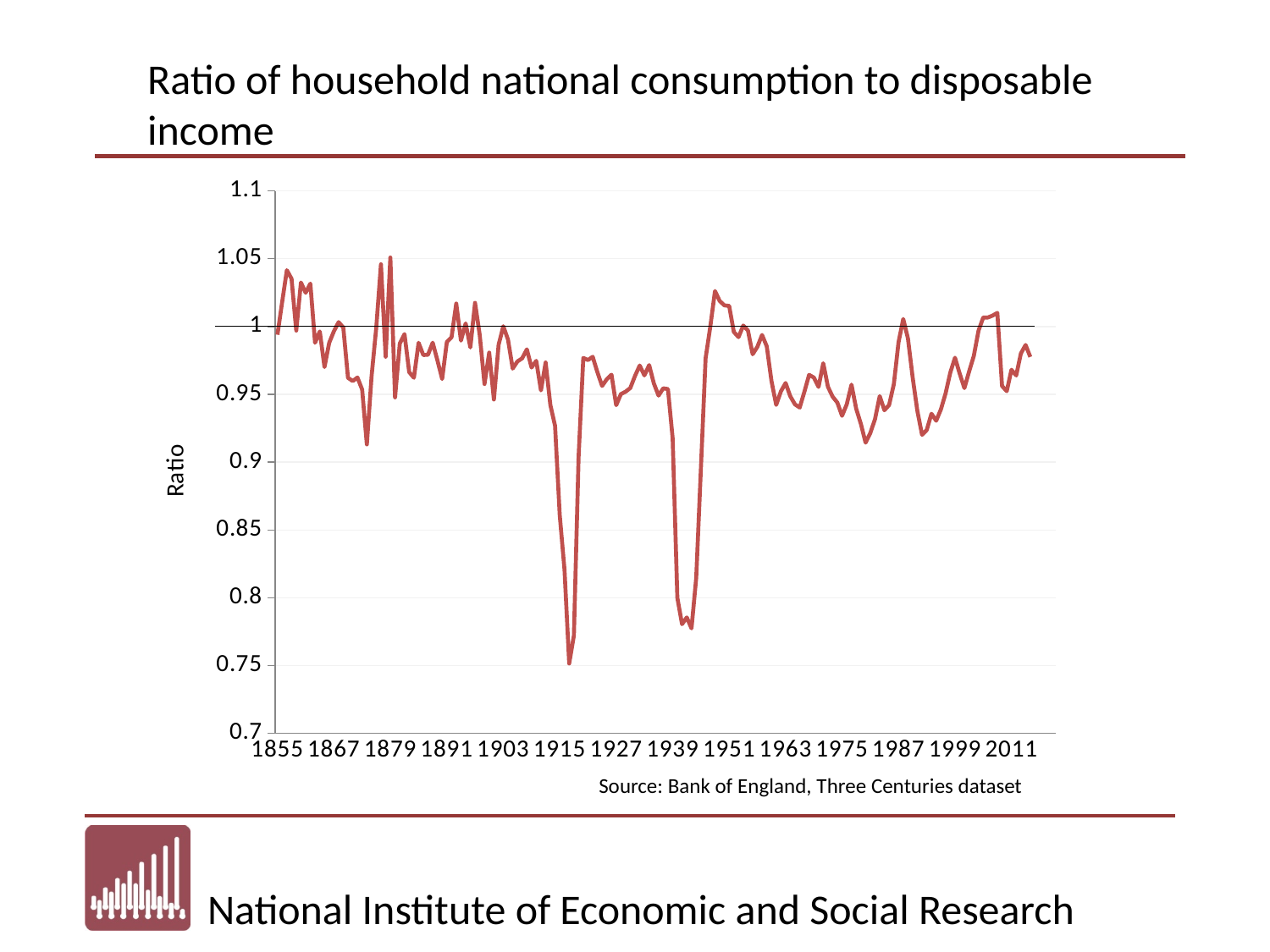
Is the value for 1939 greater or less than 1? less What kind of chart is shown on the slide? line chart Is the value for 1927 greater or less than 1? less What is the label on the vertical axis of the chart? Ratio Which of the two deep troughs on the chart is lower: the one shortly after 1915 or the one shortly after 1939? the one shortly after 1915 Is the highest value plotted on the chart greater or less than 1? greater What is the title of the chart? Ratio of household national consumption to disposable income